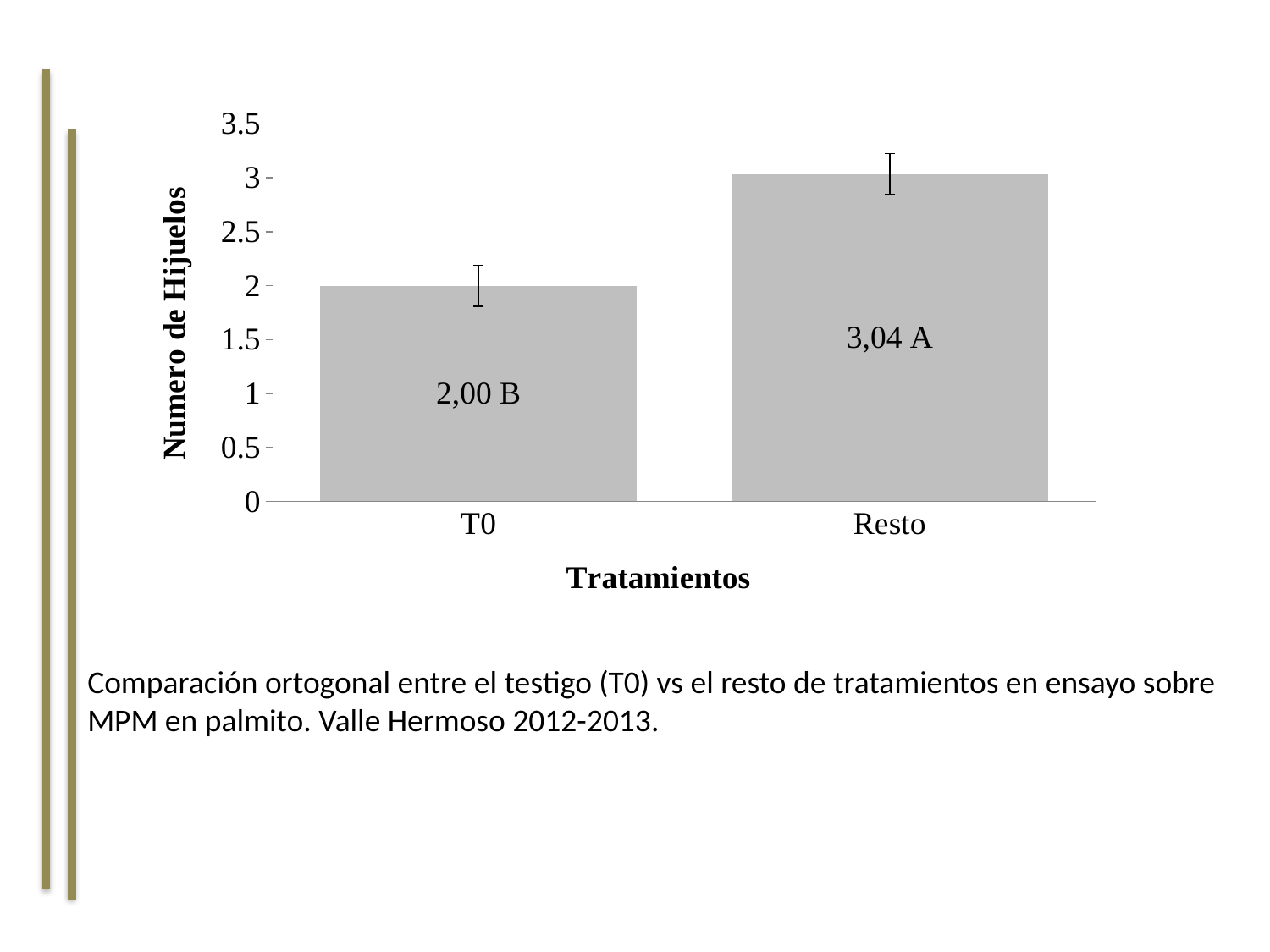
What kind of chart is shown on the slide? bar chart What is the label of the horizontal axis? Tratamientos Is the value for T0 greater or less than 2.5? less What is the label of the vertical axis? Numero de Hijuelos Which statistical group letter is shown next to the value for Resto? A What is the value shown for T0? 2,00 What is the difference between the values for Resto and T0? 1,04 How many bars are plotted in the chart? 2 Which treatment has the higher number of hijuelos? Resto Is the value for Resto greater or less than 2.5? greater What is the value shown for Resto? 3,04 Which treatment has the lower number of hijuelos? T0